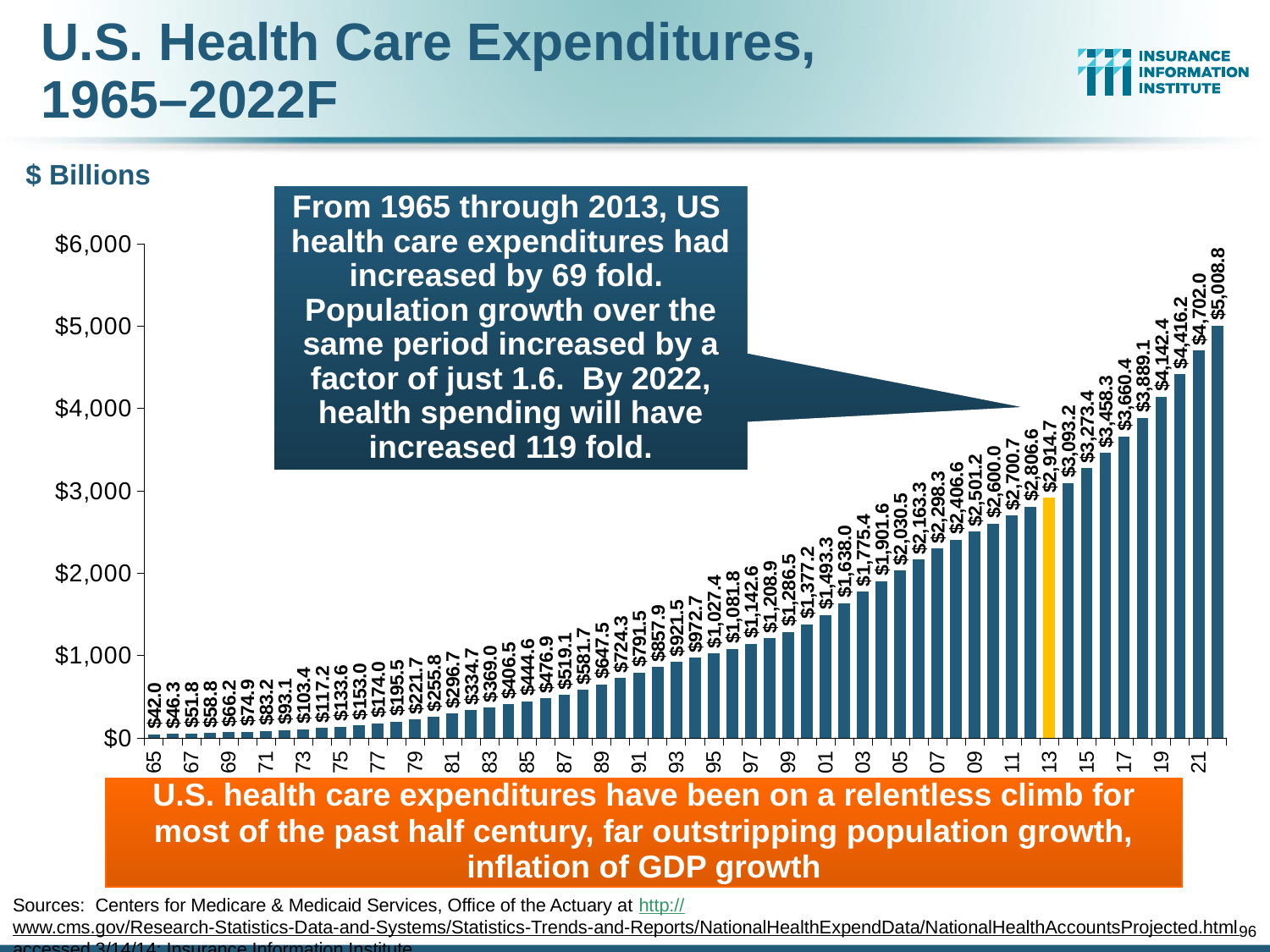
What is the value of U.S. health care expenditures for 1965 (the '65' bar)? $42.0 What unit is indicated for the y axis of the chart? $ Billions What kind of chart is shown on the slide? bar chart What is the highest value shown on the chart? $5,008.8 Which is larger, the value for '09' or the value for '05'? 09 What is the value shown for the '01' bar? $1,493.3 What is the difference between the 2013 value ($2,914.7) and the 1965 value ($42.0)? $2,872.7 What is the value shown for the '21' bar? $4,702.0 Do the values generally rise or fall from left to right along the x axis? rise Which year has the lowest health care expenditure value on the chart? 65 What is the value shown for the highlighted 2013 ('13') bar? $2,914.7 How many bars (years) are plotted on the chart? 58